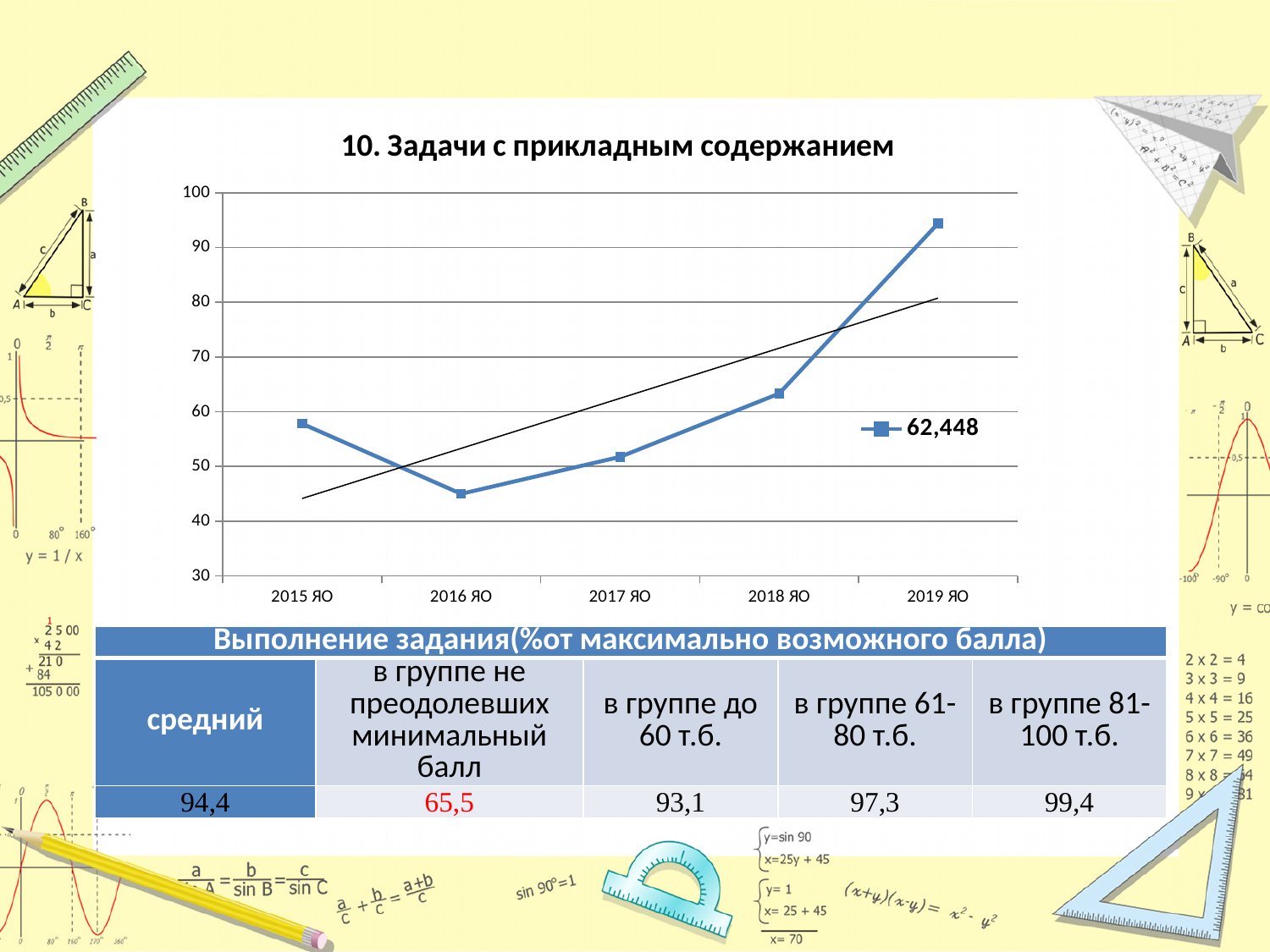
Is the value for 2015 ЯО greater or less than 50? greater What kind of chart is shown on the slide? line chart What is the legend entry for the plotted series? 62,448 Which is larger, the value for 2015 ЯО or the value for 2016 ЯО? 2015 ЯО Which year has the lowest value on the chart? 2016 ЯО Do the values rise or fall from 2016 ЯО to 2019 ЯО? rise Which year has the highest value on the chart? 2019 ЯО Is the value for 2016 ЯО greater or less than 50? less What is the title of the chart? 10. Задачи с прикладным содержанием How many points are plotted along the x axis of the chart? 5 How many series does the chart legend list? 1 Is the value for 2019 ЯО greater or less than 90? greater